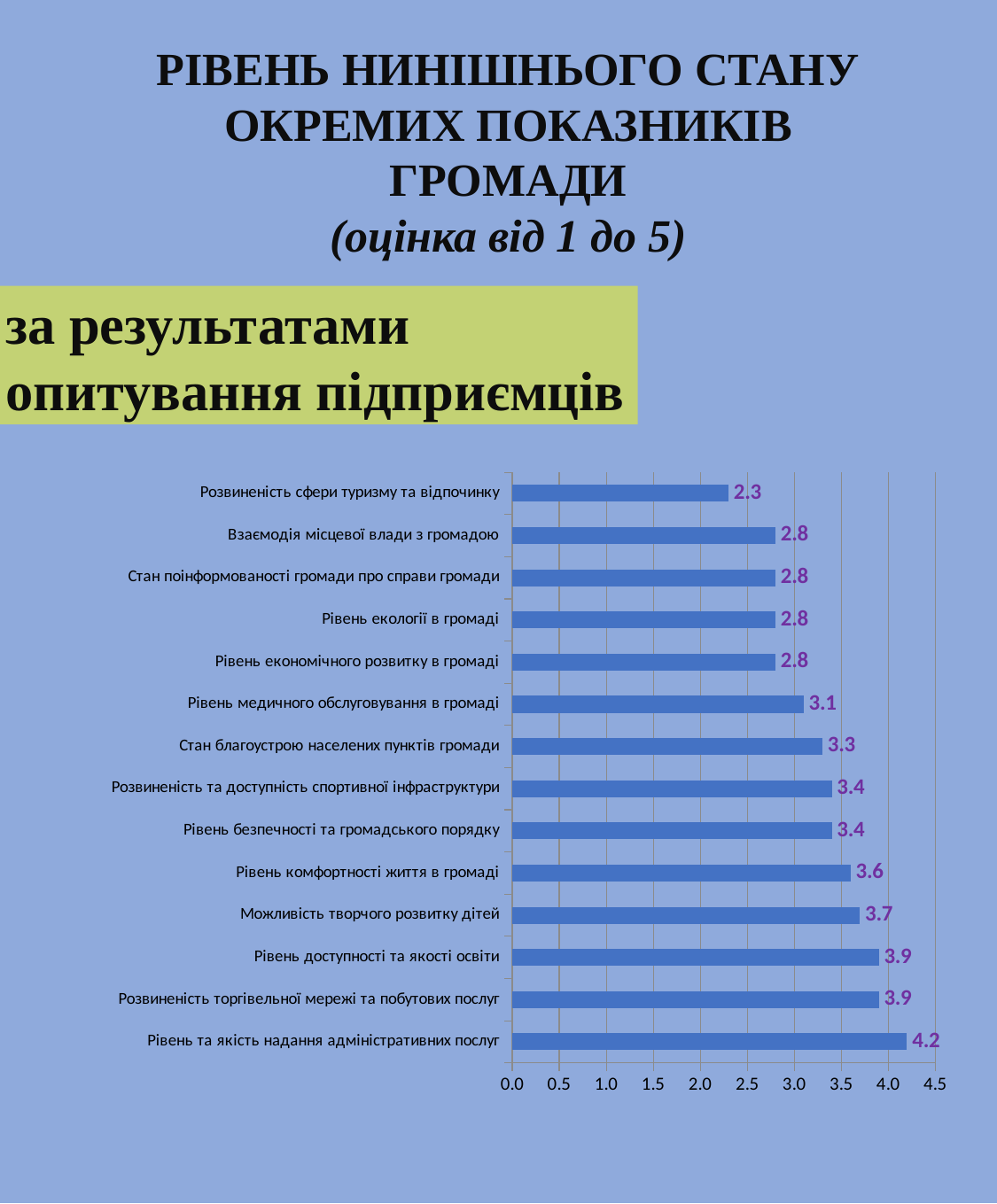
What is the value for «Рівень та якість надання адміністративних послуг»? 4.2 Which category has the highest value? Рівень та якість надання адміністративних послуг Is the value for «Стан благоустрою населених пунктів громади» greater or less than 3.0? greater Which is larger: the value for «Рівень комфортності життя в громаді» or for «Стан благоустрою населених пунктів громади»? Рівень комфортності життя в громаді How many categories are shown in the chart? 14 What is the value for «Розвиненість сфери туризму та відпочинку»? 2.3 What is the difference between the values for «Рівень та якість надання адміністративних послуг» and «Розвиненість сфери туризму та відпочинку»? 1.9 Which category has the lowest value? Розвиненість сфери туризму та відпочинку What is the value for «Рівень медичного обслуговування в громаді»? 3.1 What is the value for «Можливість творчого розвитку дітей»? 3.7 What kind of chart is shown on the slide? bar chart What is the maximum value shown on the horizontal axis? 4.5